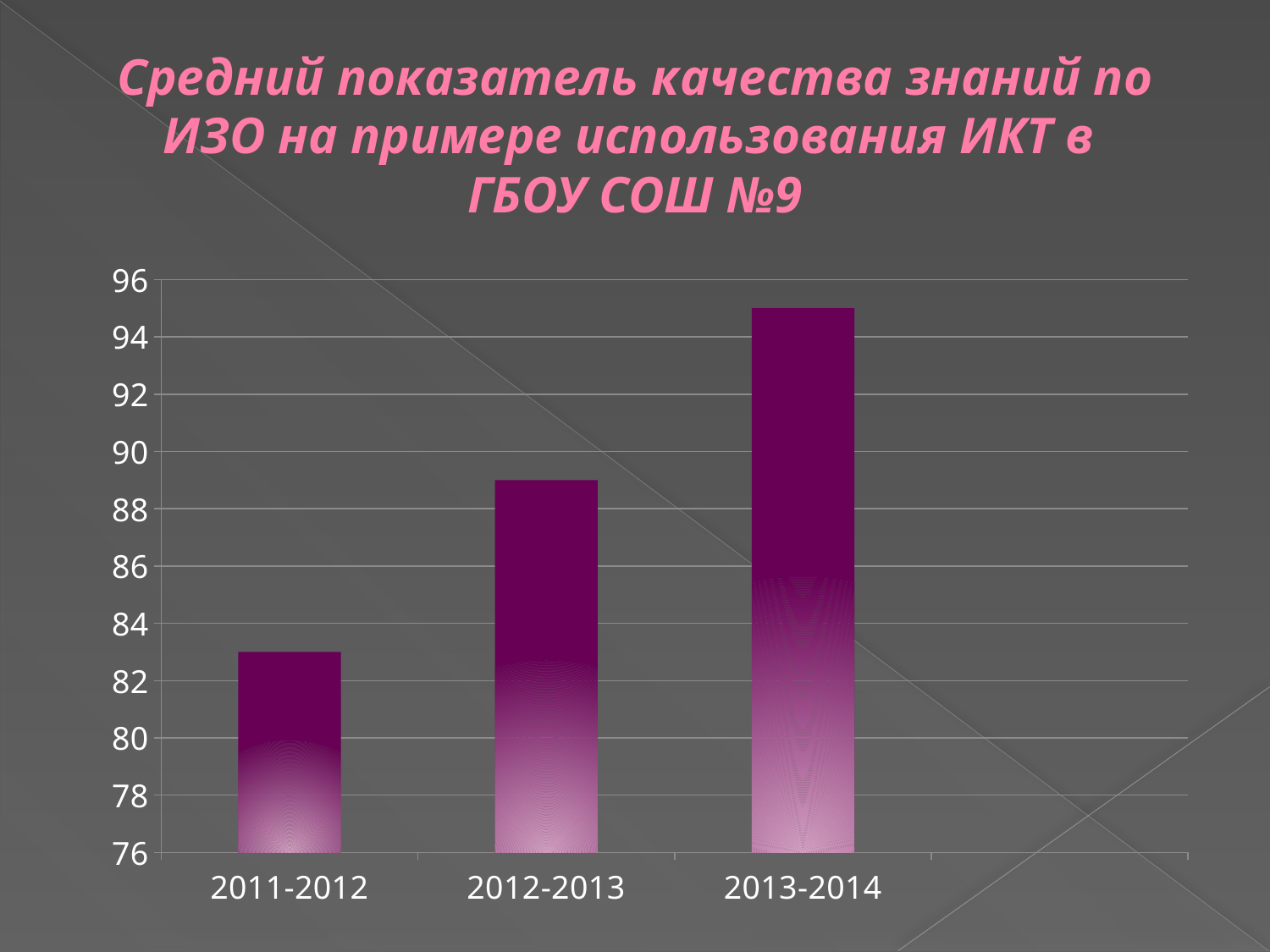
Do the values rise or fall from 2011-2012 to 2013-2014? rise Which is larger, the value for 2012-2013 or the value for 2013-2014? 2013-2014 Which school year has the lowest value? 2011-2012 Is the value for 2013-2014 greater or less than 90? greater Which is larger, the value for 2012-2013 or the value for 2011-2012? 2012-2013 How many categories (school years) are shown on the x axis? 3 Is the value for 2012-2013 greater or less than 86? greater Which school year has the highest value? 2013-2014 Is the value for 2011-2012 greater or less than 86? less What is the lowest value shown on the vertical axis? 76 What kind of chart is shown on the slide? bar chart